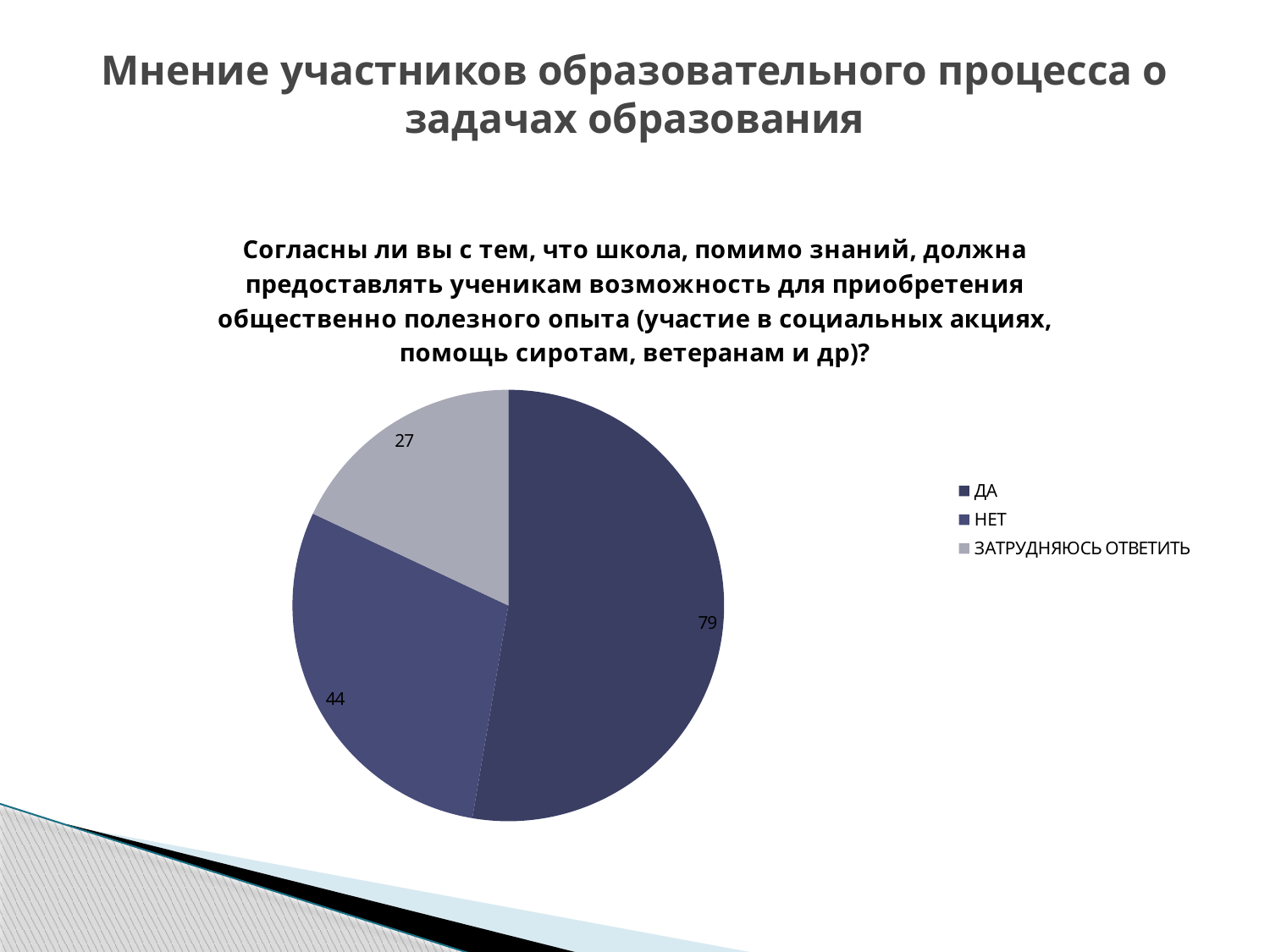
What is the value for ЗАТРУДНЯЮСЬ ОТВЕТИТЬ? 27 What is the difference between the values for НЕТ and ЗАТРУДНЯЮСЬ ОТВЕТИТЬ? 17 What is the difference between the values for ДА and НЕТ? 35 Which category has the largest slice? ДА Which category has the smallest slice? ЗАТРУДНЯЮСЬ ОТВЕТИТЬ What share of the pie does ЗАТРУДНЯЮСЬ ОТВЕТИТЬ represent? 18% What is the total of all slices in the pie chart? 150 What is the value for НЕТ? 44 What is the value for ДА? 79 What kind of chart is shown on the slide? Pie chart Which is larger, the value for НЕТ or the value for ЗАТРУДНЯЮСЬ ОТВЕТИТЬ? НЕТ How many slices does the pie chart have? 3